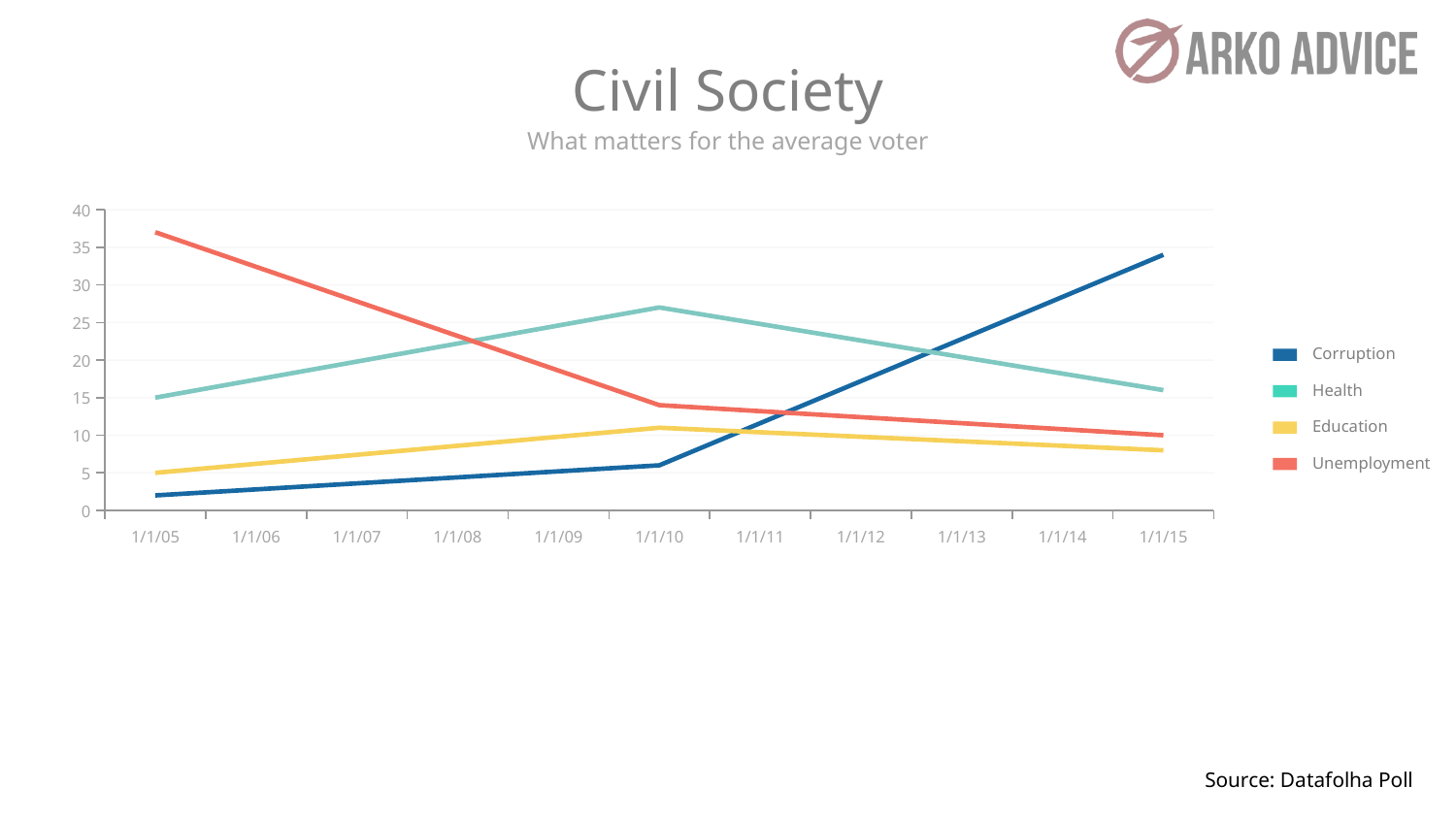
How many series does the legend list? 4 Is the value for Unemployment at 1/1/05 greater or less than 35? greater Does the Unemployment line rise or fall from 1/1/05 to 1/1/15? fall What kind of chart is shown on the slide? line chart Which series has the highest value at 1/1/05? Unemployment Is the value for Education at 1/1/15 greater or less than 10? less Which series has the highest value at 1/1/15? Corruption Is the value for Corruption at 1/1/05 greater or less than 5? less Does the Corruption line rise or fall from 1/1/05 to 1/1/15? rise At 1/1/15, which is larger: Health or Corruption? Corruption Which series has the lowest value at 1/1/05? Corruption